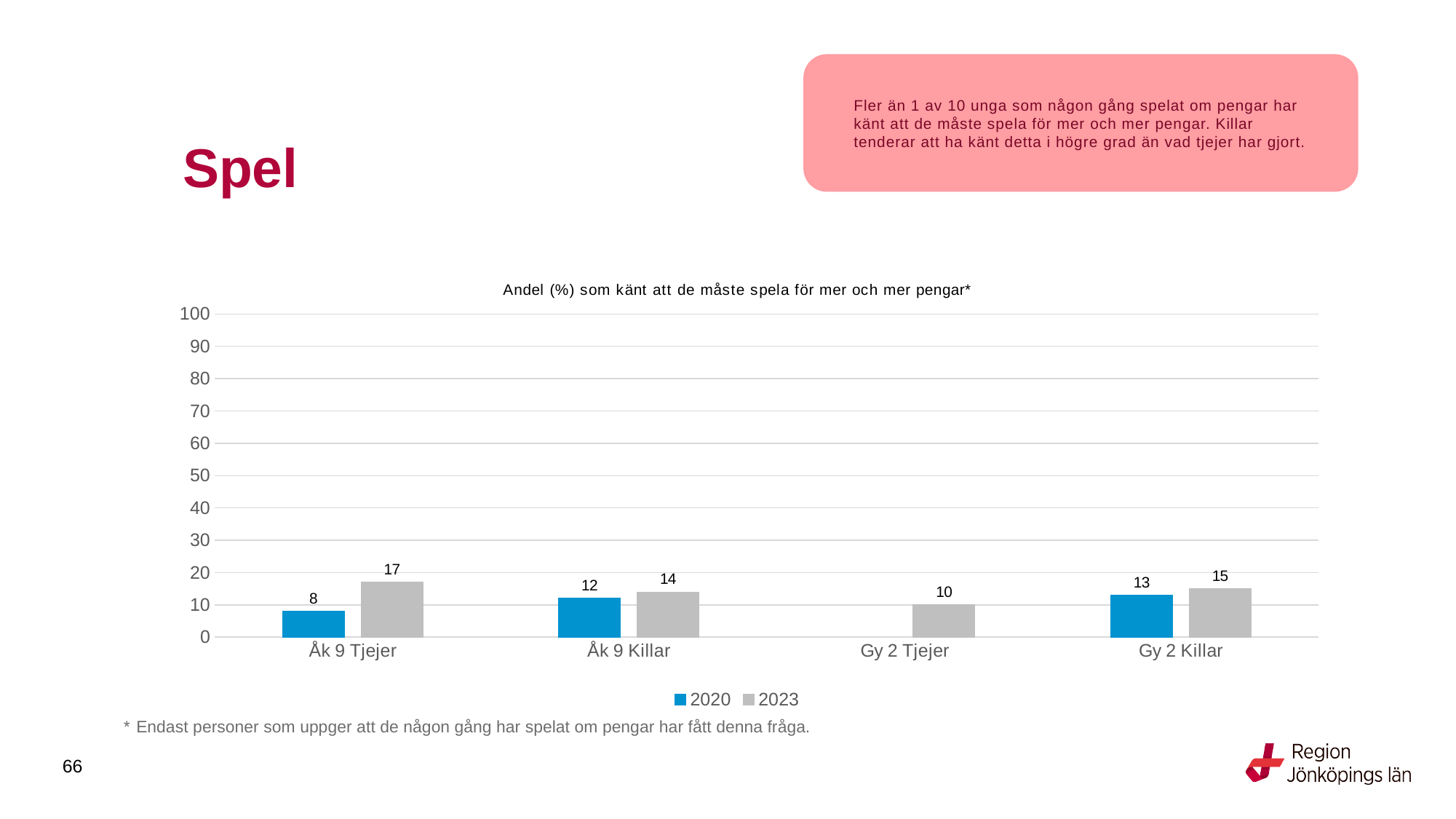
What is the difference between the 2023 and 2020 values for Åk 9 Tjejer? 9 What is the 2020 value for Åk 9 Killar? 12 Which is larger for Gy 2 Killar, the 2020 value or the 2023 value? 2023 What is the 2023 value for Gy 2 Tjejer? 10 How many categories are shown on the x axis? 4 Which category has the lowest 2020 value among those with a 2020 bar? Åk 9 Tjejer Is the 2023 value for Åk 9 Killar greater or less than 20? less What is the 2020 value for Gy 2 Killar? 13 What is the 2023 value for Åk 9 Tjejer? 17 What kind of chart is shown on the slide? bar chart Which category has the highest 2023 value? Åk 9 Tjejer How many series does the legend list? 2